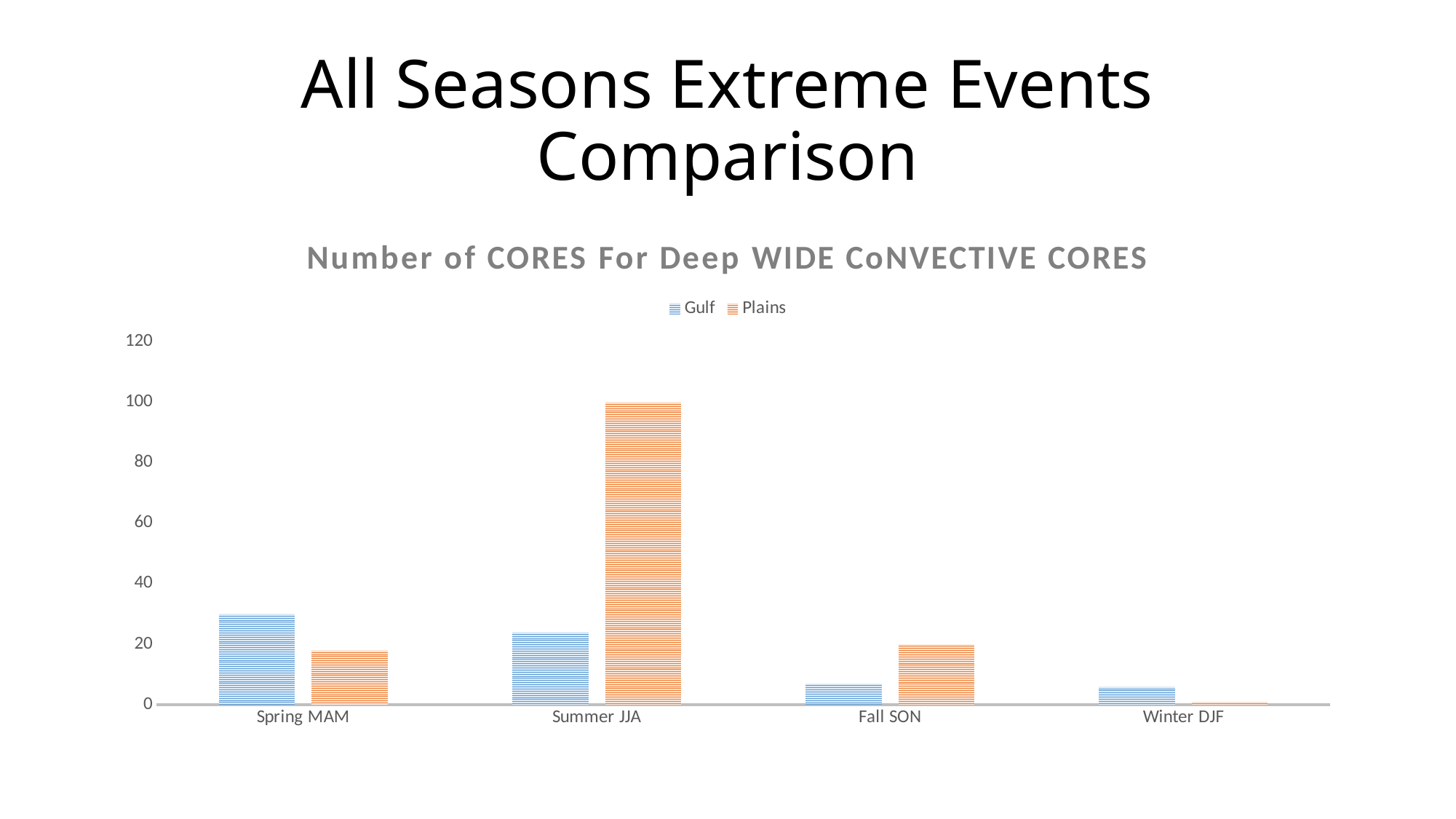
What is the title of the chart? Number of CORES For Deep WIDE CoNVECTIVE CORES Which season has the highest Plains value? Summer JJA How many series does the legend list? 2 What kind of chart is shown on the slide? bar chart Is the Plains value for Summer JJA greater or less than 80? greater Which season has the highest Gulf value? Spring MAM Is the Gulf value for Fall SON greater or less than 20? less For Summer JJA, which is larger, the Gulf value or the Plains value? Plains For Spring MAM, which is larger, the Gulf value or the Plains value? Gulf Which season has the lowest Plains value? Winter DJF Is the Gulf value for Spring MAM greater or less than 20? greater How many seasons (categories) are shown on the x axis? 4